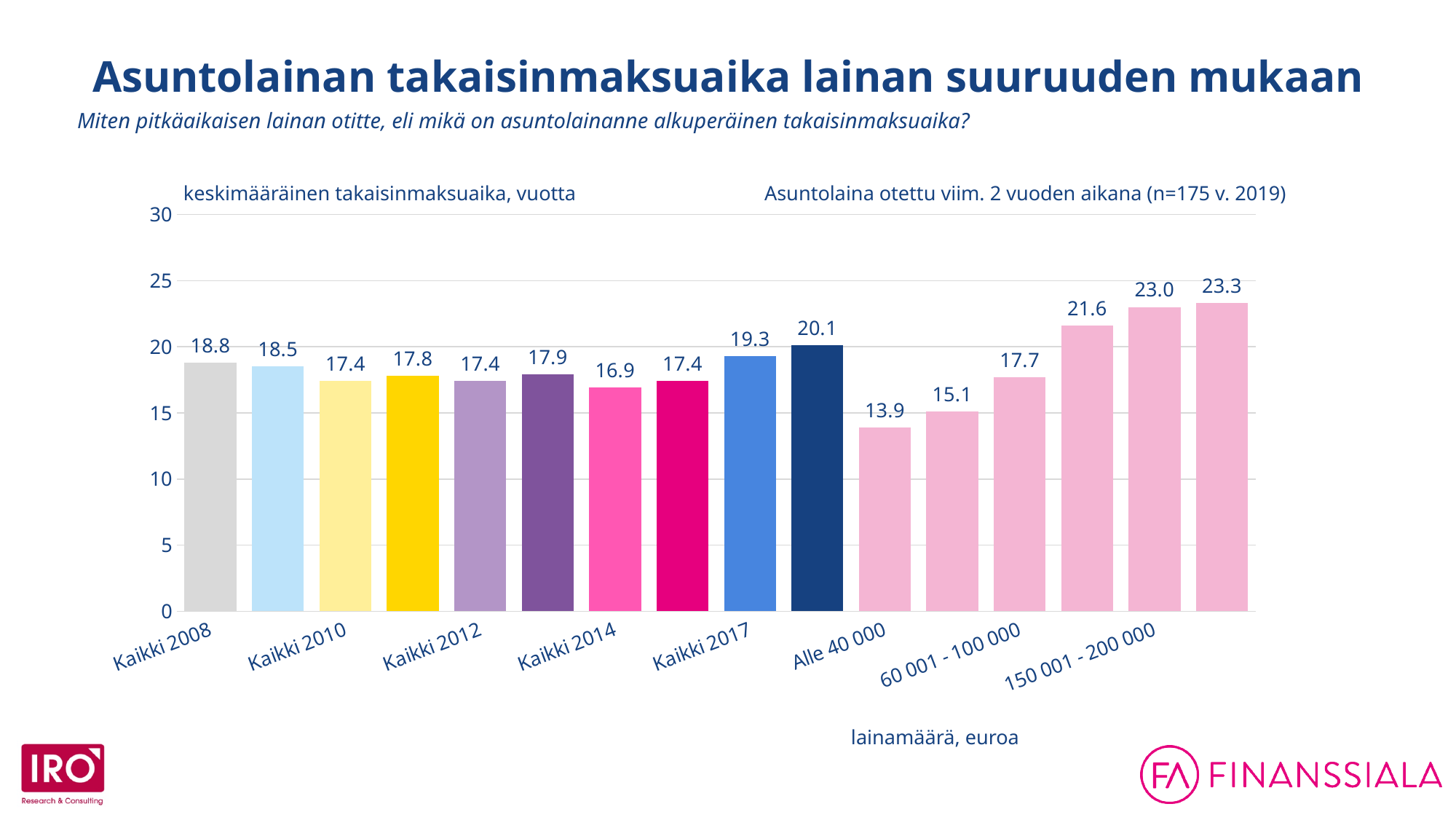
Is the value for Alle 40 000 greater or less than 15? less What kind of chart is shown on the slide? bar chart How many bars are shown on the chart? 16 Which is larger, the value for Kaikki 2012 or Kaikki 2014? Kaikki 2012 What is the highest value shown on the chart? 23.3 What is the difference between the values for 150 001 - 200 000 and Alle 40 000? 9.1 What is the value for 60 001 - 100 000? 17.7 What is the value for Kaikki 2008? 18.8 What is the value for 150 001 - 200 000? 23.0 What is the value for Kaikki 2017? 19.3 Which category has the lowest value? Alle 40 000 What is the value for Alle 40 000? 13.9